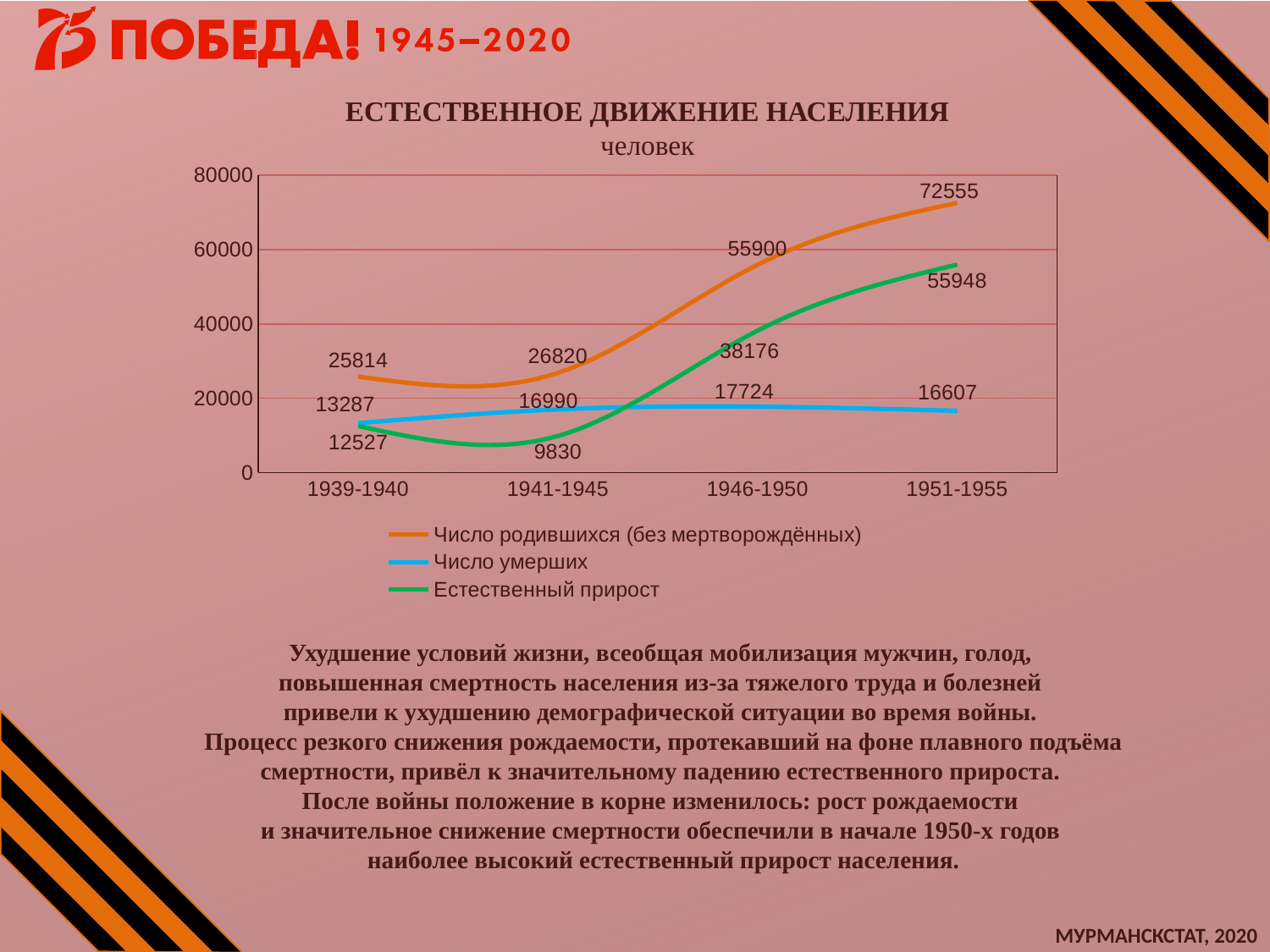
What is the difference between Число родившихся (без мертворождённых) and Число умерших in 1939-1940? 12527 What colour is the line for Естественный прирост? green What is the value of Естественный прирост for 1946-1950? 38176 What type of chart is shown on the slide? line chart How many series does the legend list? 3 In which period is Естественный прирост lowest? 1941-1945 What is the value of Число умерших for 1941-1945? 16990 What is the value of Число родившихся (без мертворождённых) for 1951-1955? 72555 How many periods are shown on the x axis? 4 Does Число родившихся (без мертворождённых) rise or fall from 1941-1945 to 1951-1955? rise In which period is Число умерших highest? 1946-1950 Which is larger in 1941-1945: Число умерших or Естественный прирост? Число умерших